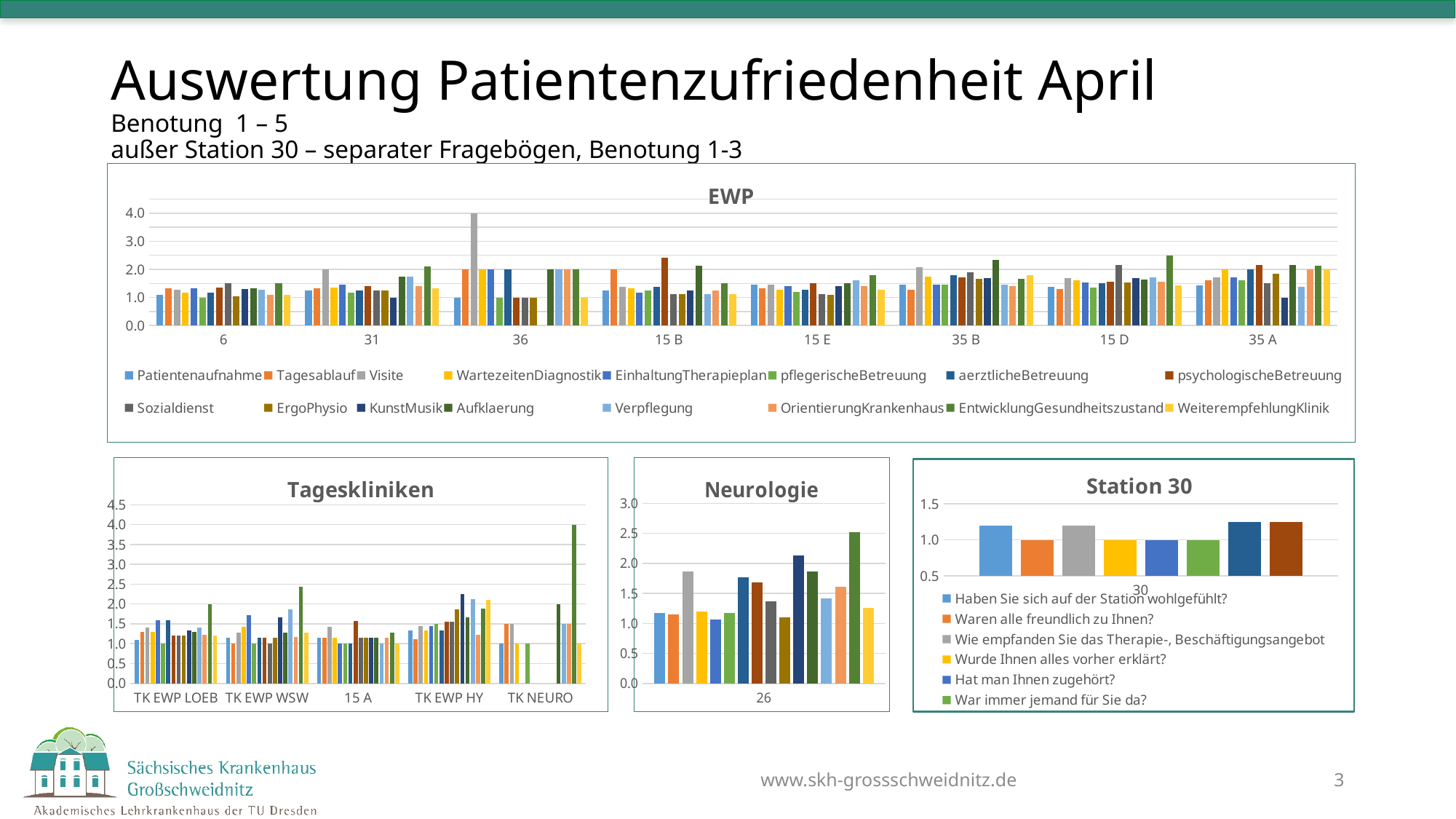
In the Tageskliniken chart, is the tallest bar for TK NEURO greater or less than 3.5? greater In the Station 30 chart, which is larger: 'Haben Sie sich auf der Station wohlgefühlt?' or 'Waren alle freundlich zu Ihnen?'? Haben Sie sich auf der Station wohlgefühlt? In the EWP chart, is the value of Visite for category 36 greater or less than 3.0? greater In the Tageskliniken chart, which category contains the tallest bar? TK NEURO How many categories are shown on the x axis of the Neurologie chart? 1 In the EWP chart, which category contains the tallest bar? 36 How many categories are shown on the x axis of the Tageskliniken chart? 5 How many series does the legend of the EWP chart list? 16 How many categories are shown on the x axis of the EWP chart? 8 What kind of chart is the EWP chart at the top of the slide? bar chart In the Station 30 chart, is the value for 'Haben Sie sich auf der Station wohlgefühlt?' greater or less than 1.0? greater How many series does the legend of the Station 30 chart list? 6